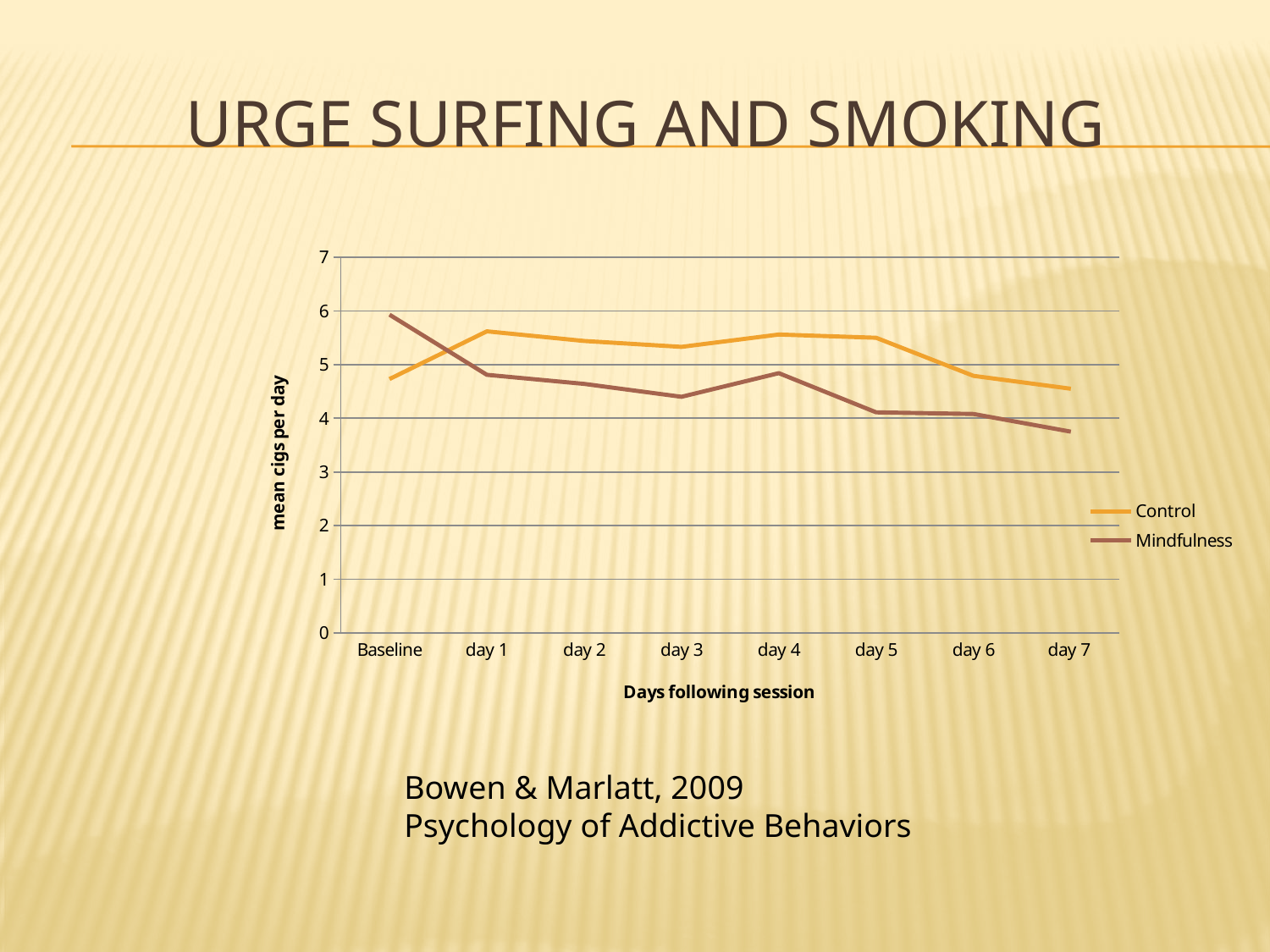
At day 5, which series has the higher value, Control or Mindfulness? Control How many series does the legend list? 2 How many points are plotted along the x axis for each series? 8 Is the Mindfulness value at day 7 greater or less than 4? less Does the Mindfulness series rise or fall from day 4 to day 7? fall Is the Mindfulness value at Baseline greater or less than 5? greater What kind of chart is shown on the slide? line chart What is the title of the vertical axis? mean cigs per day Is the Control value at day 1 greater or less than 5? greater At which point on the x axis does the Mindfulness series reach its highest value? Baseline At Baseline, which series has the higher value, Control or Mindfulness? Mindfulness At which point on the x axis does the Mindfulness series reach its lowest value? day 7